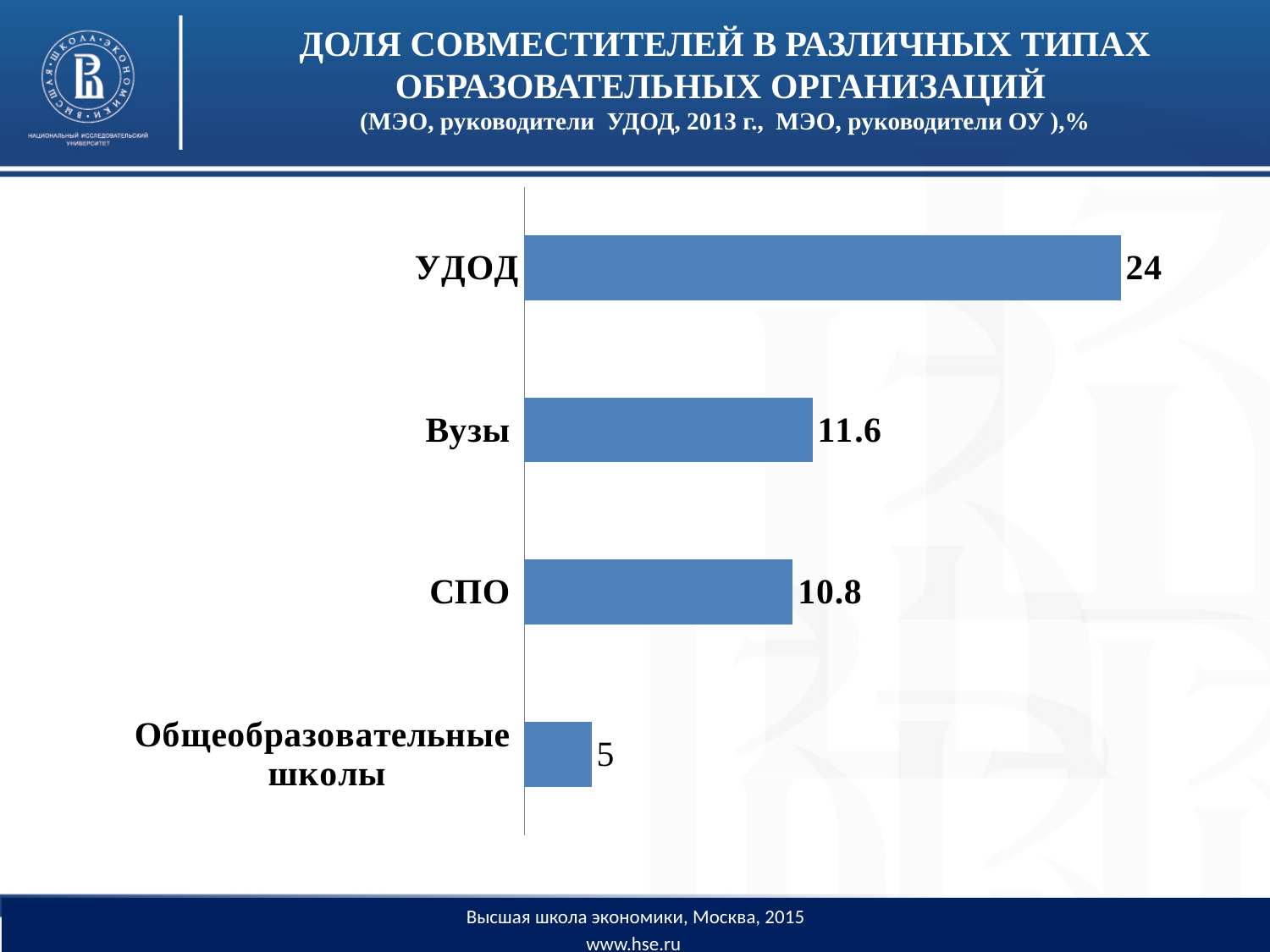
What is the difference between the values for УДОД and Вузы? 12.4 What is the value for Общеобразовательные школы? 5 Which is larger, the value for УДОД or the value for СПО? УДОД How many categories are shown in the chart? 4 What is the difference between the values for Вузы and СПО? 0.8 What is the value for СПО? 10.8 Which category has the highest value? УДОД What is the difference between the values for СПО and Общеобразовательные школы? 5.8 Which category has the lowest value? Общеобразовательные школы What is the value for Вузы? 11.6 What is the value for УДОД? 24 What kind of chart is shown on the slide? Bar chart